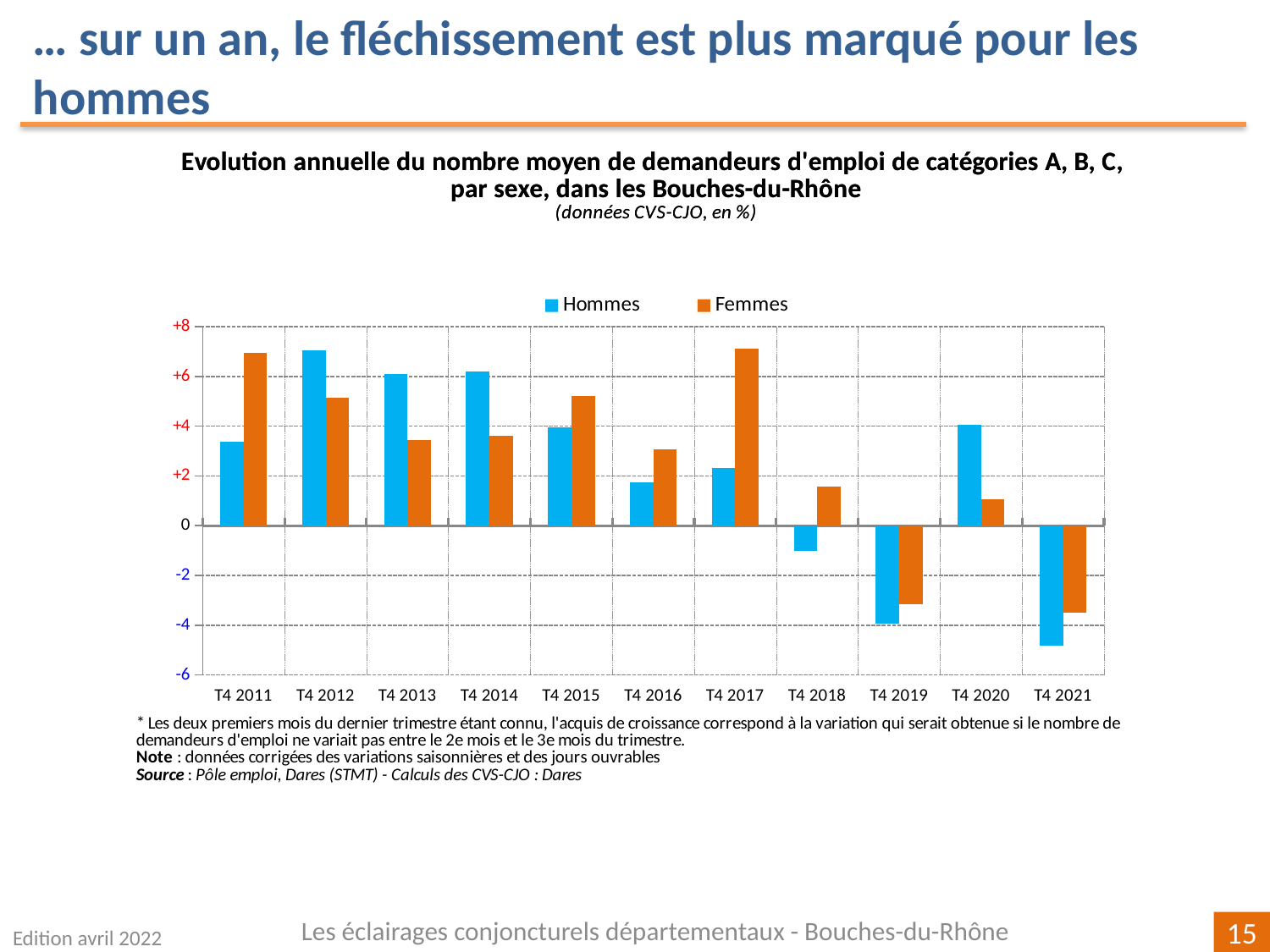
In T4 2017, which series has the larger value, Hommes or Femmes? Femmes Is the value for Hommes in T4 2021 greater or less than -4? less How many quarters (categories) are shown on the x axis? 11 In which quarter is the value for Hommes the highest? T4 2012 In T4 2020, which series has the larger value, Hommes or Femmes? Hommes In which quarter is the value for Hommes the lowest? T4 2021 How many series does the legend list? 2 Is the value for Femmes in T4 2018 greater or less than 0? greater Is the value for Femmes in T4 2019 greater or less than -2? less Which colour represents the Hommes series in the chart? blue What kind of chart is shown on the slide? bar chart